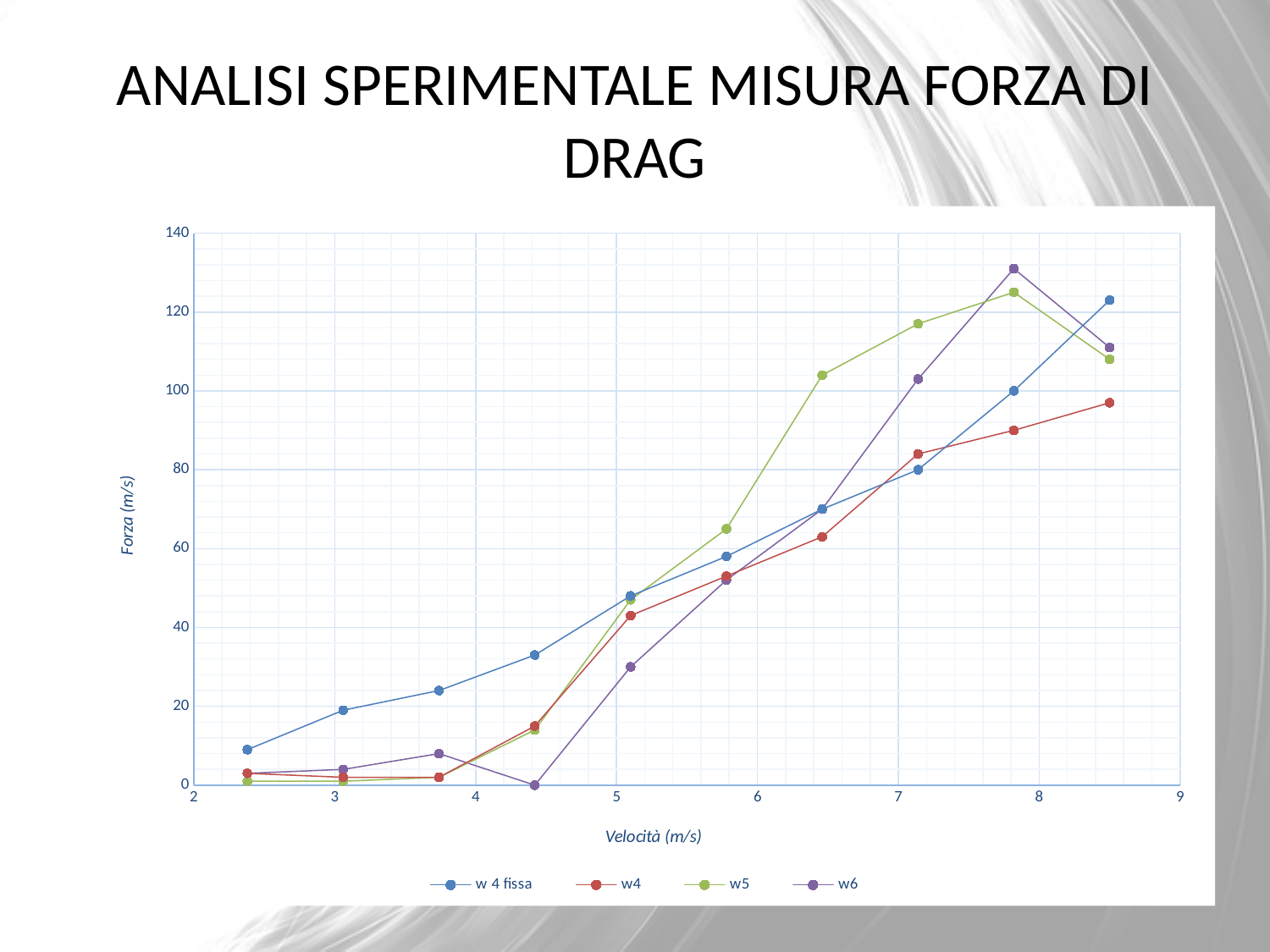
Is the value for w4 at a velocity of about 8.5 m/s greater or less than 100? less What is the title of the x axis? Velocità (m/s) How many series does the legend list? 4 At a velocity of about 6.45 m/s, which is larger: w5 or w4? w5 Is the value for w6 at a velocity of about 4.4 m/s greater or less than 20? less At a velocity of about 8.5 m/s, which is larger: w 4 fissa or w4? w 4 fissa Is the value for w6 at a velocity of about 7.8 m/s greater or less than 120? greater Do the values of the w 4 fissa series rise or fall as velocity increases? rise What kind of chart is shown on the slide? line chart How many data points does the w 4 fissa series have? 10 Which series reaches the highest value on the chart? w6